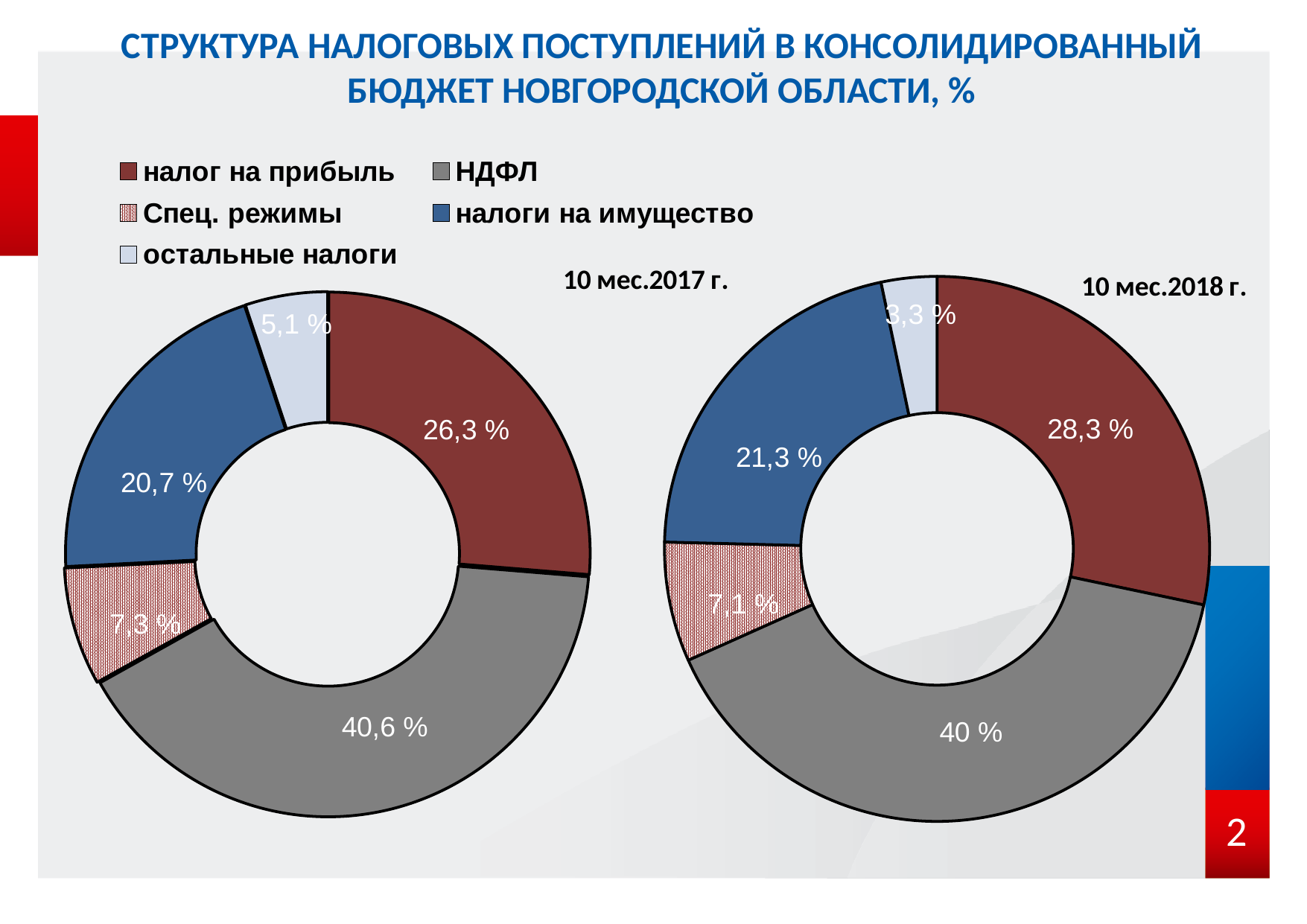
In the '10 мес.2018 г.' chart, what is the value for остальные налоги? 3,3 % What is the difference between the налог на прибыль share in the '10 мес.2018 г.' chart and in the '10 мес.2017 г.' chart? 2 % In the '10 мес.2017 г.' chart, what is the value for налоги на имущество? 20,7 % In the '10 мес.2018 г.' chart, what share does налог на прибыль have? 28,3 % In the '10 мес.2018 г.' chart, what is the value for Спец. режимы? 7,1 % In the '10 мес.2017 г.' chart, which category has the smallest share? остальные налоги In the '10 мес.2018 г.' chart, which category has the largest share? НДФЛ What type of chart is used on the slide? Doughnut (pie) chart In the '10 мес.2017 г.' chart, which is larger: Спец. режимы or остальные налоги? Спец. режимы In the '10 мес.2017 г.' chart, what share does НДФЛ have? 40,6 % Which legend entry is shown in dark red? налог на прибыль How many categories does each doughnut chart on the slide show? 5